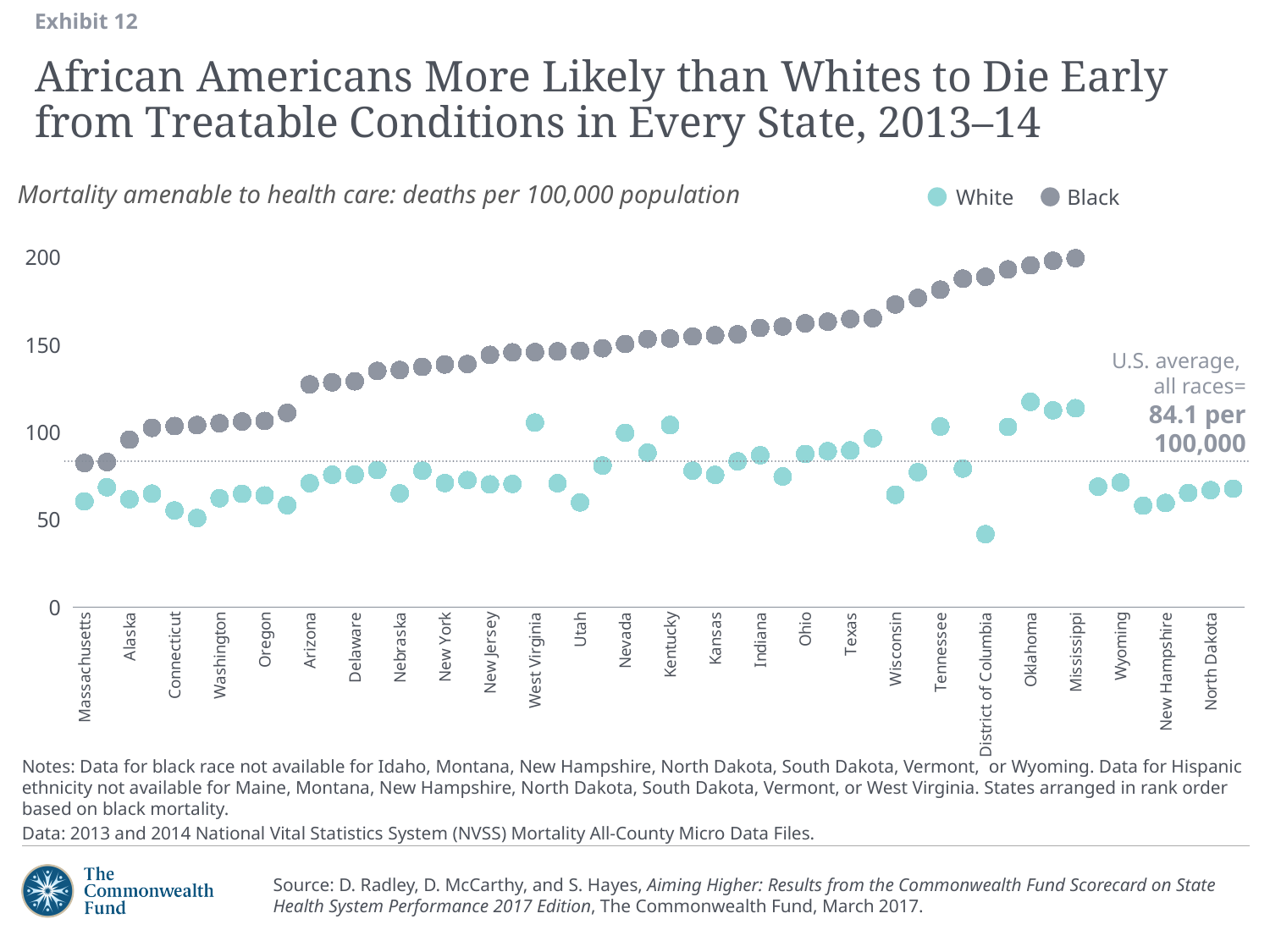
Is the Black mortality value for Mississippi greater or less than 150? greater Which state has the lowest Black mortality value on the chart? Massachusetts Is the White mortality value for District of Columbia greater or less than 50? less Is the White mortality value for Oklahoma greater or less than 100? greater Which state has the highest Black mortality value on the chart? Mississippi Which state has the lowest White mortality value on the chart? District of Columbia How many series does the legend list? 2 Do the Black mortality values rise or fall moving from left to right along the x axis? rise For Texas, which is larger: the Black mortality value or the White mortality value? Black What is the U.S. average mortality amenable to health care for all races shown on the chart? 84.1 per 100,000 What are the two series shown in the legend? White and Black